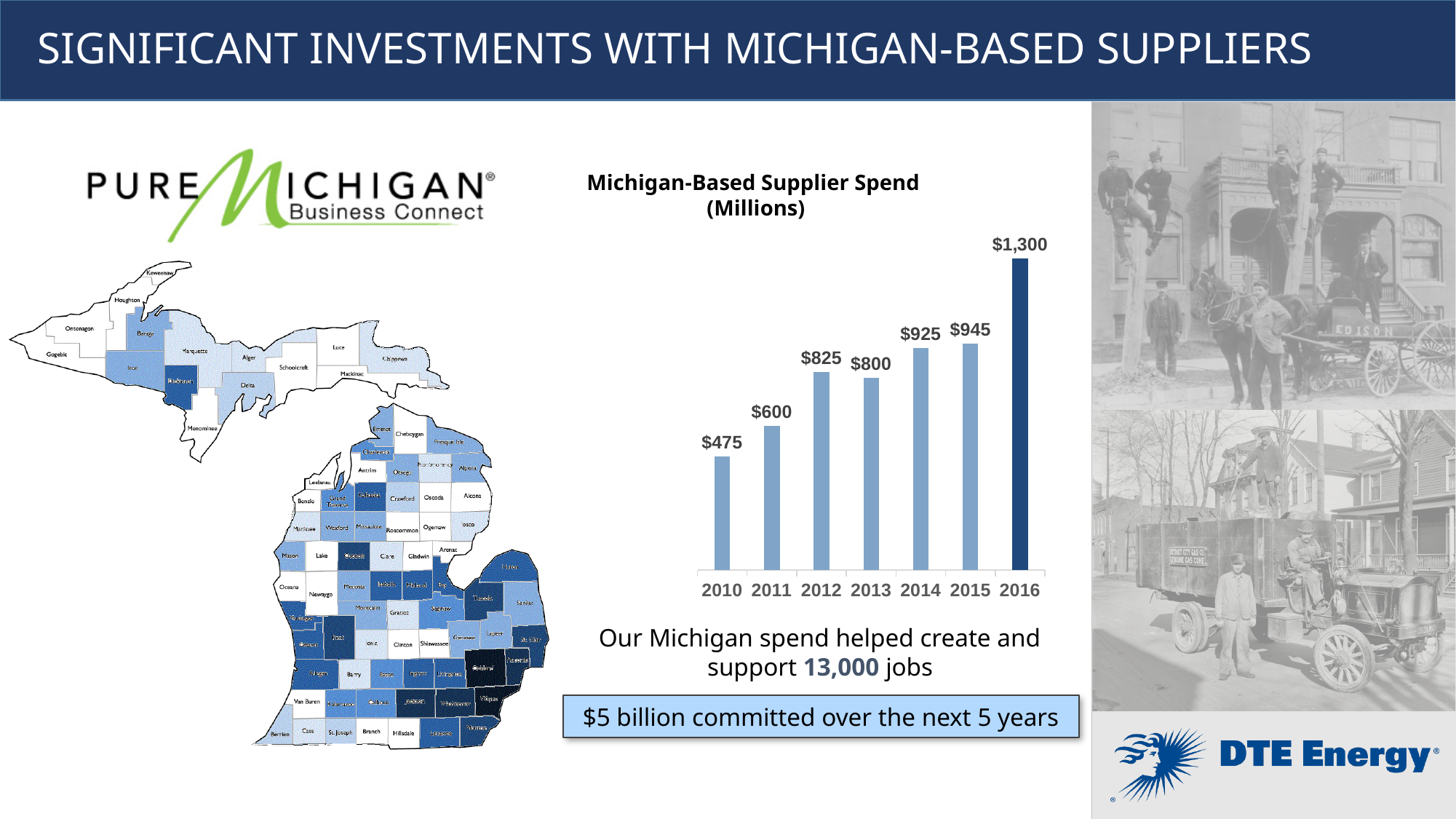
What is the Michigan-based supplier spend for 2010? $475 How many years are shown in the Michigan-Based Supplier Spend chart? 7 What is the difference in supplier spend between 2011 and 2010? $125 What is the difference in supplier spend between 2016 and 2015? $355 What is the title of the chart on the slide? Michigan-Based Supplier Spend (Millions) Which year had a larger supplier spend, 2012 or 2013? 2012 What kind of chart is the Michigan-Based Supplier Spend chart? Bar chart Which year has the lowest Michigan-based supplier spend? 2010 What is the Michigan-based supplier spend for 2012? $825 Which year has the highest Michigan-based supplier spend? 2016 Does the supplier spend generally rise or fall from 2010 to 2016? Rise What is the Michigan-based supplier spend for 2016? $1,300